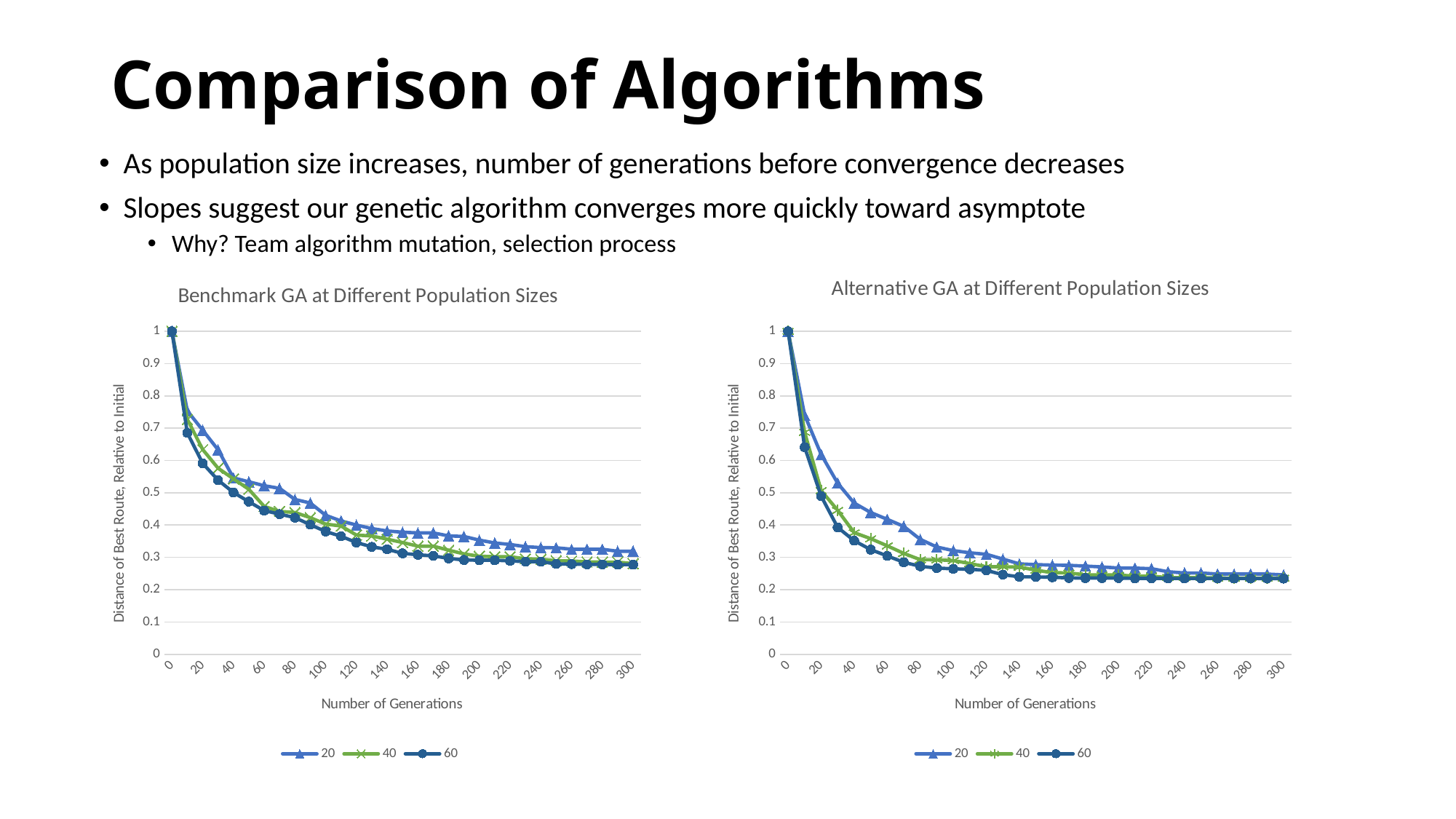
What is the y-axis title of the 'Benchmark GA at Different Population Sizes' chart? Distance of Best Route, Relative to Initial What is the x-axis title of the 'Alternative GA at Different Population Sizes' chart? Number of Generations In the 'Alternative GA at Different Population Sizes' chart, what is the value of every series at 0 generations? 1 In the 'Alternative GA at Different Population Sizes' chart, is the value for series 20 at 300 generations greater or less than 0.3? less In the 'Benchmark GA at Different Population Sizes' chart, at 100 generations, which series has the larger value: 20 or 60? 20 In the 'Alternative GA at Different Population Sizes' chart, is the value for series 60 at 100 generations greater or less than 0.4? less How many series does the legend of the 'Alternative GA at Different Population Sizes' chart list? 3 In the 'Benchmark GA at Different Population Sizes' chart, do the values rise or fall as the number of generations increases? fall In the 'Benchmark GA at Different Population Sizes' chart, is the value for series 20 at 20 generations greater or less than 0.6? greater In the 'Alternative GA at Different Population Sizes' chart, at 60 generations, which series has the lowest value? 60 What kind of chart is the 'Benchmark GA at Different Population Sizes' chart? line chart